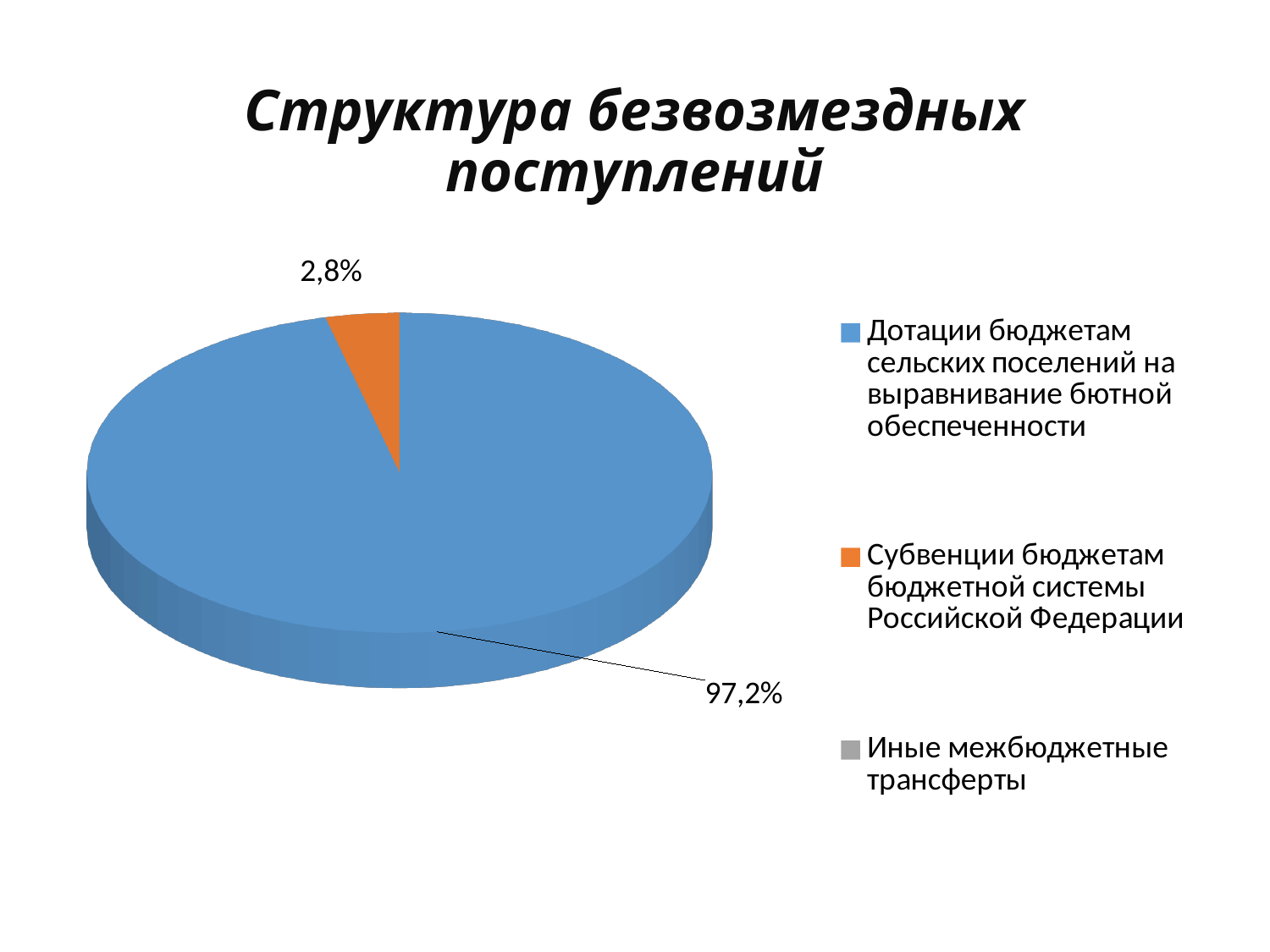
Which category has the largest slice of the pie? Дотации бюджетам сельских поселений на выравнивание бютной обеспеченности What is the title of the chart? Структура безвозмездных поступлений What is the difference in percentage points between the Дотации slice and the Субвенции slice? 94,4 Which is larger: the share for Дотации бюджетам сельских поселений or the share for Субвенции бюджетам бюджетной системы Российской Федерации? Дотации бюджетам сельских поселений What share of the pie is labelled for Дотации бюджетам сельских поселений на выравнивание бютной обеспеченности? 97,2% How many slices of the pie are labelled with a percentage? 2 Is the share for Дотации бюджетам сельских поселений greater or less than 50%? greater Which of the labelled slices is the smallest? Субвенции бюджетам бюджетной системы Российской Федерации What type of chart is shown on the slide? Pie chart What share of the pie is labelled for Субвенции бюджетам бюджетной системы Российской Федерации? 2,8% How many entries does the legend list? 3 What colour is the slice for Субвенции бюджетам бюджетной системы Российской Федерации? Orange